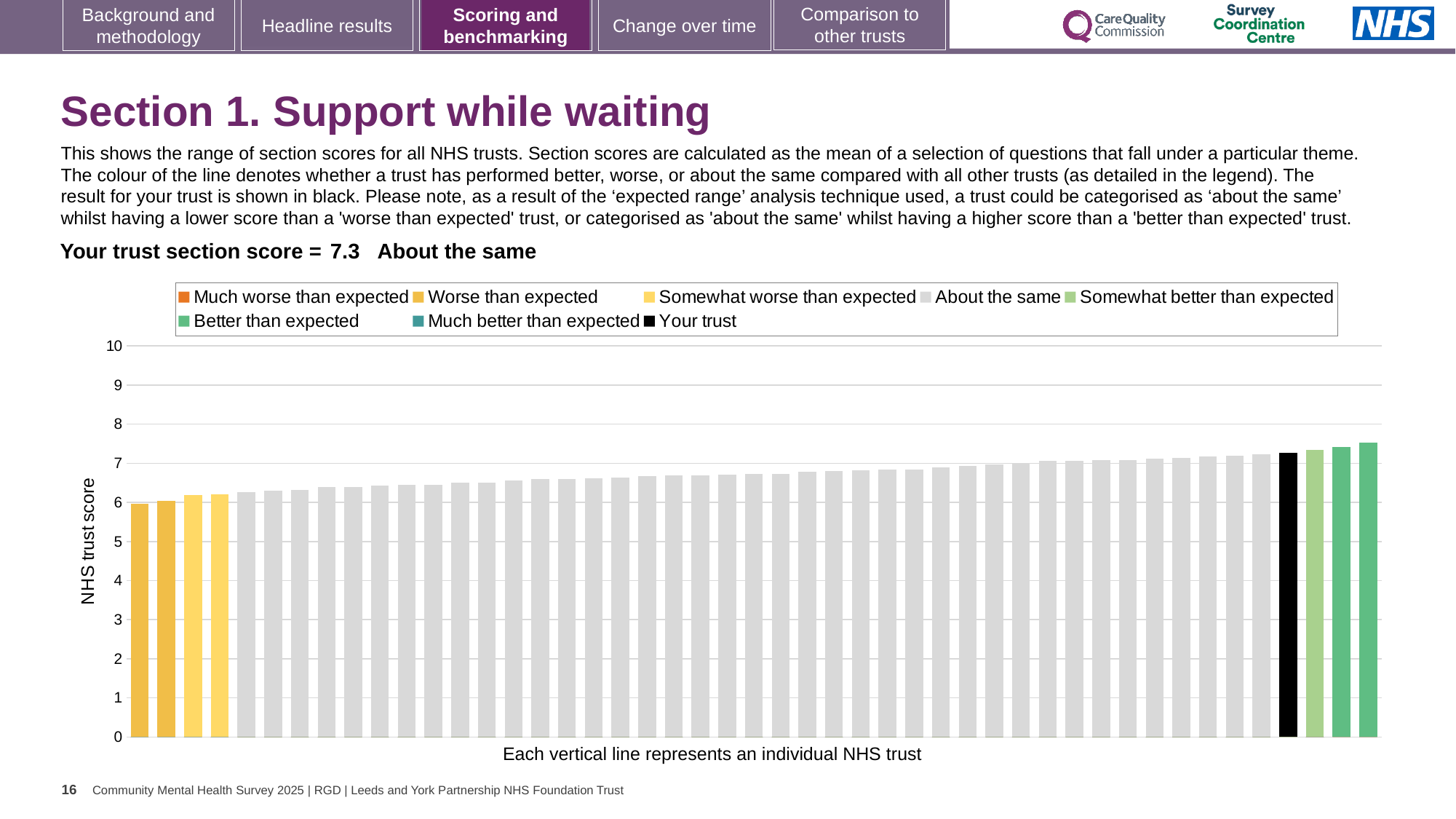
What is the section score for your trust shown on the slide? 7.3 What kind of chart is shown on the slide? bar chart What colour is the bar representing your trust? black How many bars are coloured green (better than expected)? 3 How many entries does the chart legend list? 8 Do the bar values rise or fall from left to right along the x axis? rise Is the value of the black bar (your trust) greater or less than 7? greater What is the label on the vertical axis of the chart? NHS trust score Is the value of the shortest bar greater or less than 5? greater How many bars are coloured yellow (worse or somewhat worse than expected)? 4 Is the value of the tallest bar greater or less than 8? less Which category does your trust fall into for this section? About the same